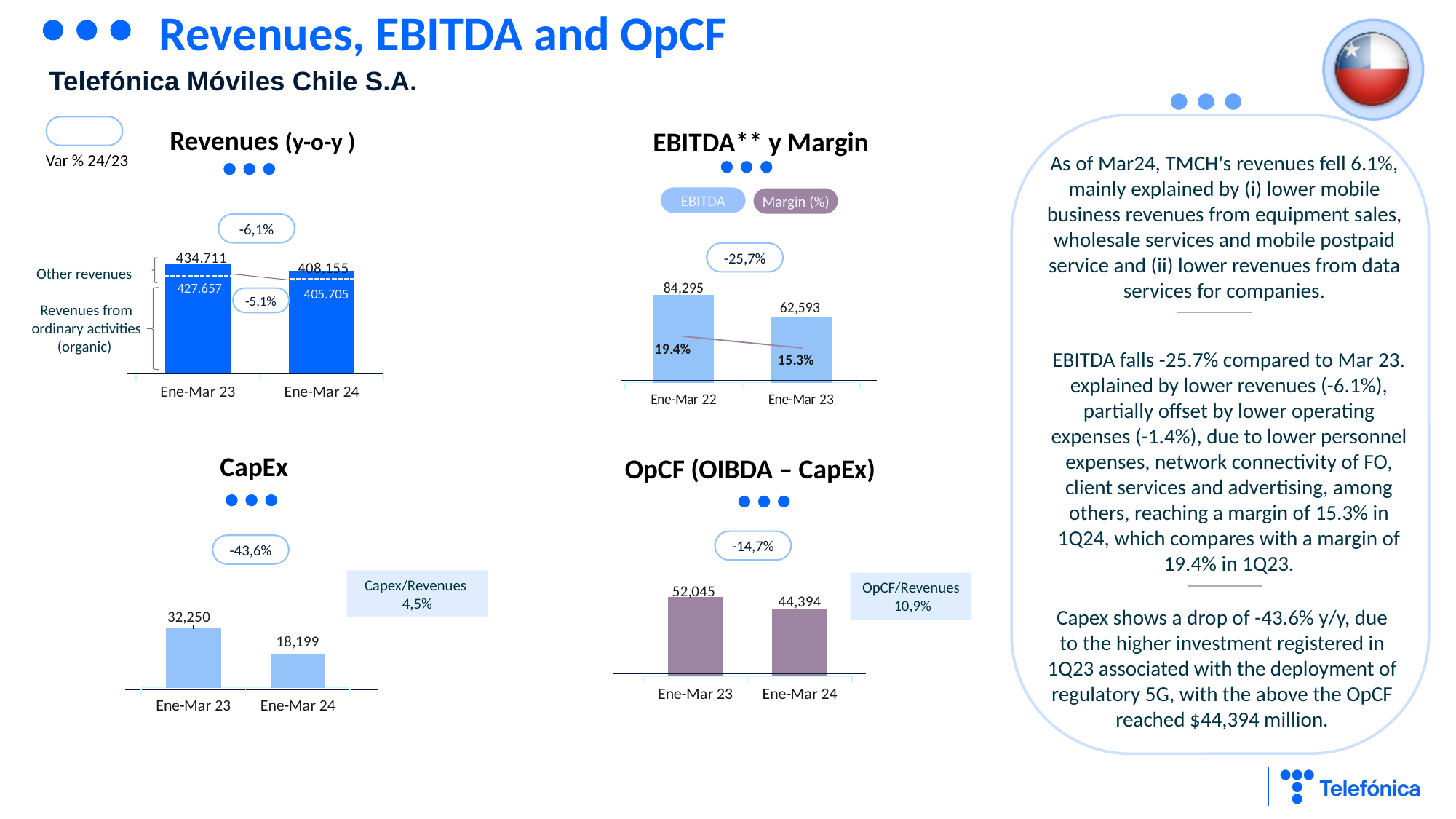
In the EBITDA** y Margin chart, what margin percentage is shown for Ene-Mar 22? 19.4% In the OpCF (OIBDA – CapEx) chart, do the values rise or fall from Ene-Mar 23 to Ene-Mar 24? fall How many series does the legend of the EBITDA** y Margin chart list? 2 In the CapEx chart, what is the difference between the Ene-Mar 23 and Ene-Mar 24 values? 14,051 In the EBITDA** y Margin chart, what is the difference between the EBITDA values for Ene-Mar 22 and Ene-Mar 23? 21,702 In the CapEx chart, which period has the lower value? Ene-Mar 24 In the Revenues (y-o-y) chart, what is the total revenue value labelled for Ene-Mar 24? 408,155 In the OpCF (OIBDA – CapEx) chart, what is the value labelled for Ene-Mar 23? 52,045 In the Revenues (y-o-y) chart, what is the year-on-year variation shown for total revenues? -6,1% In the EBITDA** y Margin chart, what is the EBITDA value labelled for Ene-Mar 23? 62,593 In the Revenues (y-o-y) chart, what is the value labelled for revenues from ordinary activities (organic) for Ene-Mar 23? 427.657 In the OpCF (OIBDA – CapEx) chart, what is the difference between the Ene-Mar 23 and Ene-Mar 24 values? 7,651